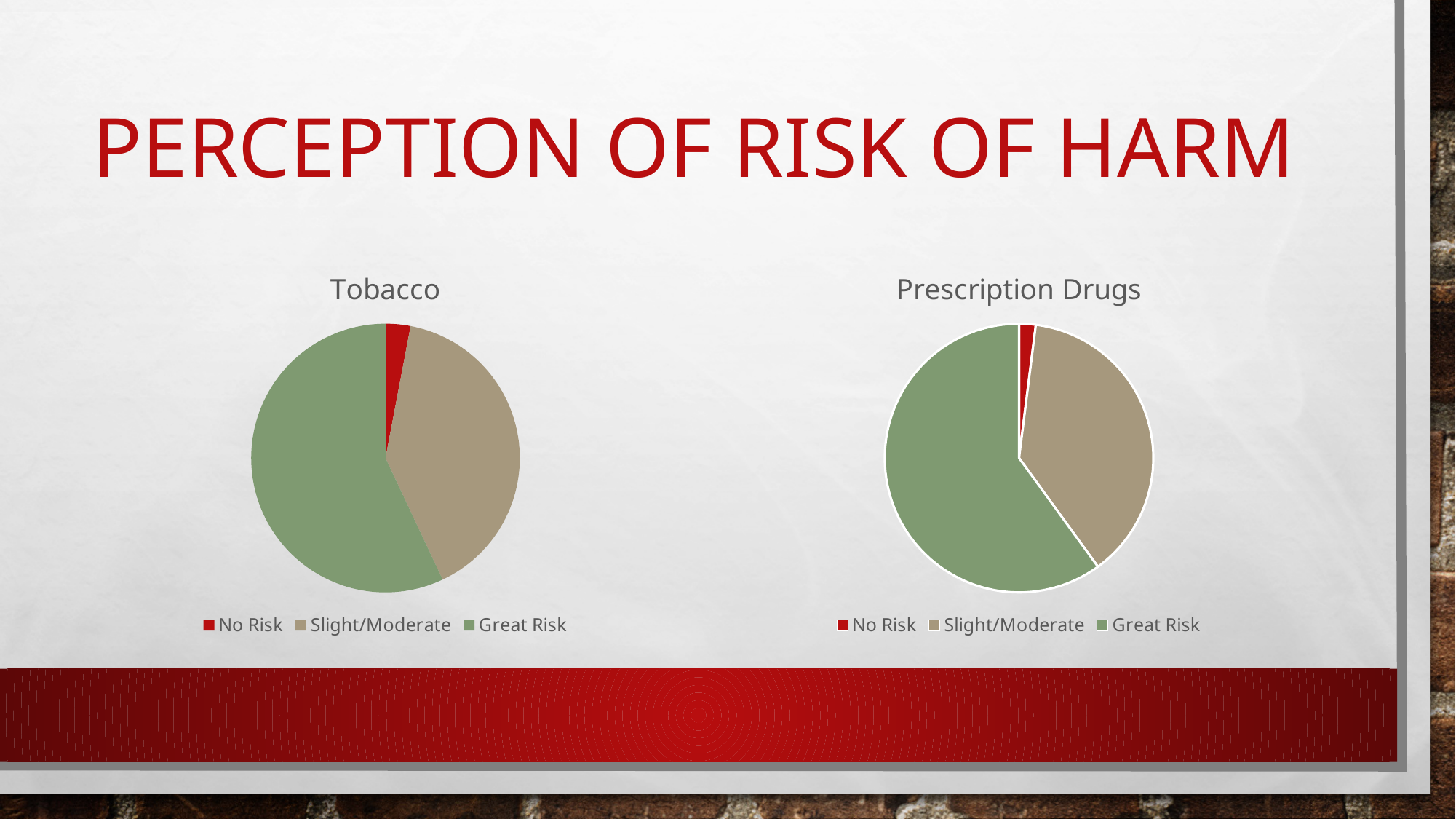
In the Tobacco chart, which colour represents the No Risk category? red In the Prescription Drugs chart, which category has the largest slice? Great Risk What kind of chart is the Prescription Drugs chart? pie chart What kind of chart is the Tobacco chart? pie chart What is the title of the pie chart on the right side of the slide? Prescription Drugs In the Tobacco chart, which category has the smallest slice? No Risk In the Tobacco chart, which category has the largest slice? Great Risk In the Tobacco chart, which slice is larger: Slight/Moderate or No Risk? Slight/Moderate How many entries does the legend of the Prescription Drugs chart list? 3 In the Prescription Drugs chart, which slice is larger: Great Risk or Slight/Moderate? Great Risk In the Prescription Drugs chart, which category has the smallest slice? No Risk How many slices does the Tobacco pie chart have? 3